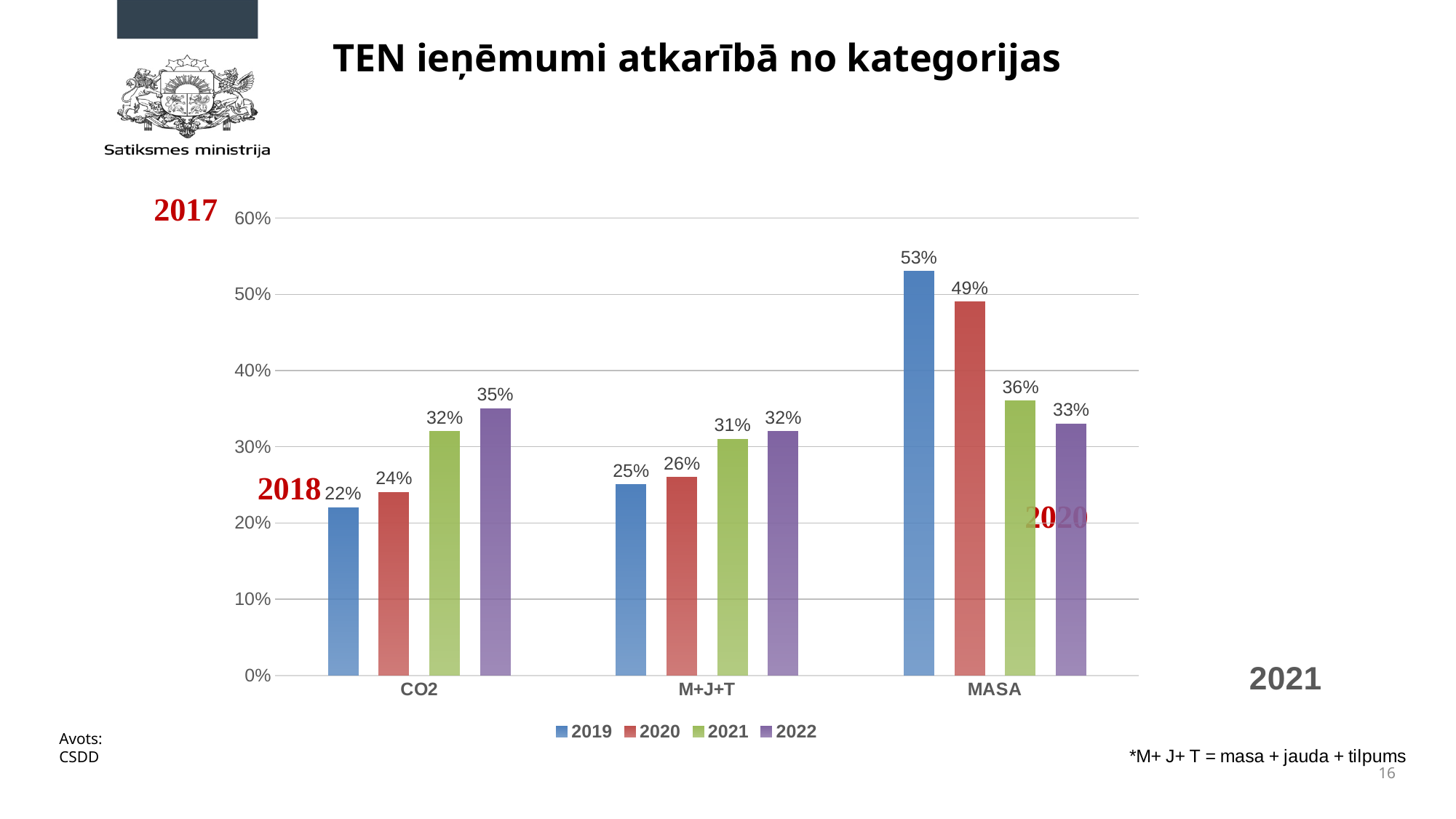
What is the title of the chart on the slide? TEN ieņēmumi atkarībā no kategorijas Which category has the lowest value in the 2021 series? M+J+T What is the value for MASA in the 2020 series? 49% How many categories are shown on the x axis? 3 Which category has the highest value in the 2019 series? MASA Which is larger for CO2: the 2021 value or the 2022 value? 2022 What is the value for M+J+T in the 2022 series? 32% What kind of chart is shown on the slide? bar chart Do the values for MASA rise or fall from 2019 to 2022? fall What is the difference between the 2019 and 2022 values for MASA? 20% What is the value for CO2 in the 2019 series? 22% How many series does the legend list? 4